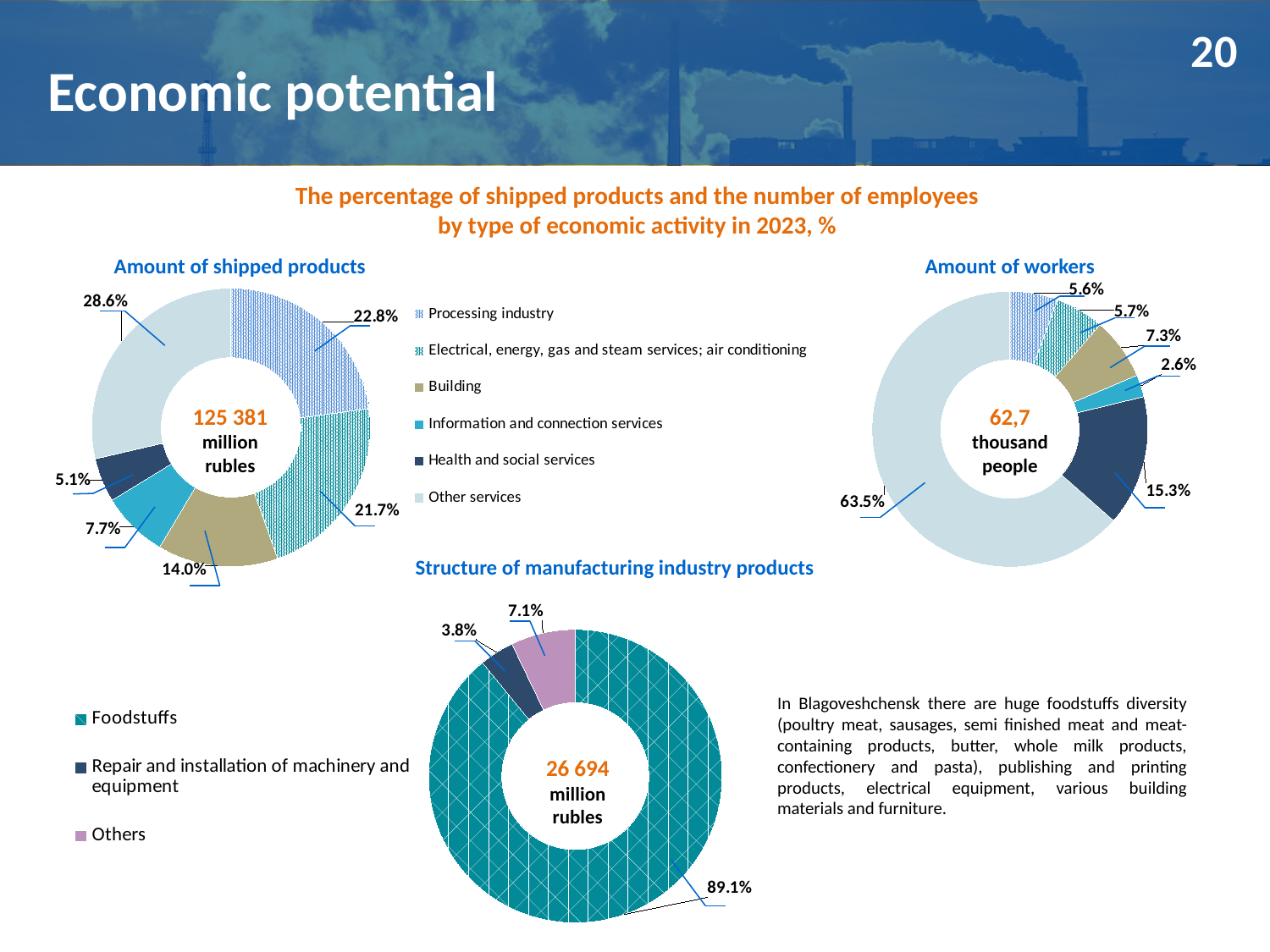
How many categories are shown in the 'Structure of manufacturing industry products' chart? 3 What type of chart is used for 'Amount of workers'? Pie (donut) chart In the 'Structure of manufacturing industry products' chart, what is the difference in percentage points between Foodstuffs and Others? 82.0 percentage points In the 'Amount of shipped products' chart, what percentage is shown for Processing industry? 22.8% In the 'Amount of shipped products' chart, which category has the largest share? Other services In the 'Amount of workers' chart, which category has the smallest share? Information and connection services How many categories are shown in the 'Amount of shipped products' chart? 6 In the 'Amount of workers' chart, which is larger: Building or Electrical, energy, gas and steam services; air conditioning? Building What value is printed in the centre of the 'Amount of shipped products' chart? 125 381 million rubles In the 'Amount of workers' chart, what percentage is shown for Health and social services? 15.3% In the 'Amount of shipped products' chart, what is the difference in percentage points between Processing industry and Electrical, energy, gas and steam services; air conditioning? 1.1 percentage points In the 'Structure of manufacturing industry products' chart, what share do Foodstuffs have? 89.1%